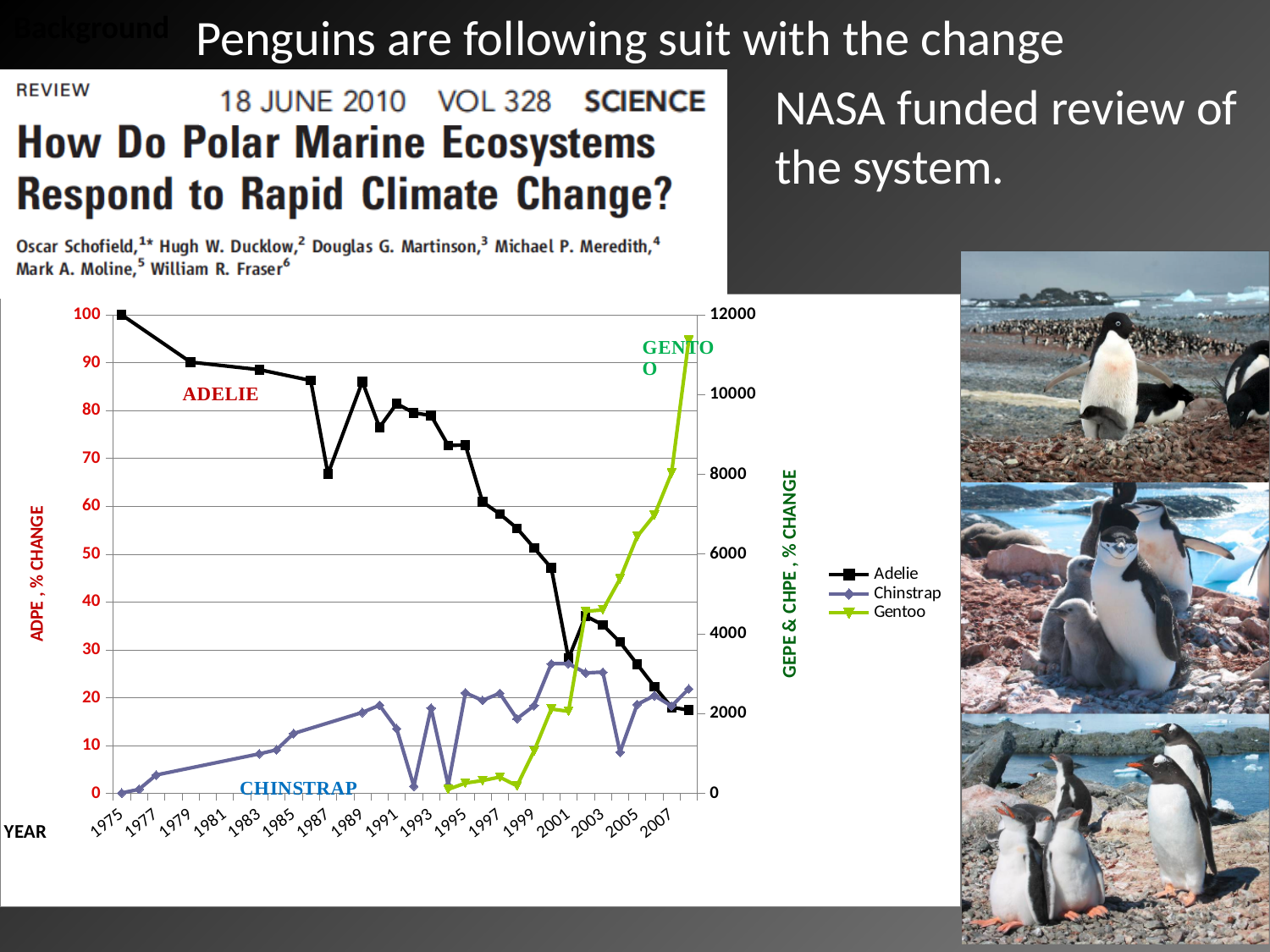
In 2007, which series has the higher value on the right axis, Gentoo or Chinstrap? Gentoo In which year is the Adelie series at its highest? 1975 What is the title of the left vertical axis of the chart? ADPE , % CHANGE What kind of chart is shown on the slide? line chart Does the Adelie series generally rise or fall from 1975 to 2007? fall What is the Adelie value in 1975? 100 Which series are listed in the chart legend? Adelie, Chinstrap, Gentoo Does the Gentoo series rise or fall from 1994 to 2007? rise How many series does the chart legend list? 3 Is the Gentoo value in 2007 on the right axis greater or less than 10000? less Is the Adelie value in 2007 on the left axis greater or less than 20? less Is the Adelie value in 1987 on the left axis greater or less than 70? less